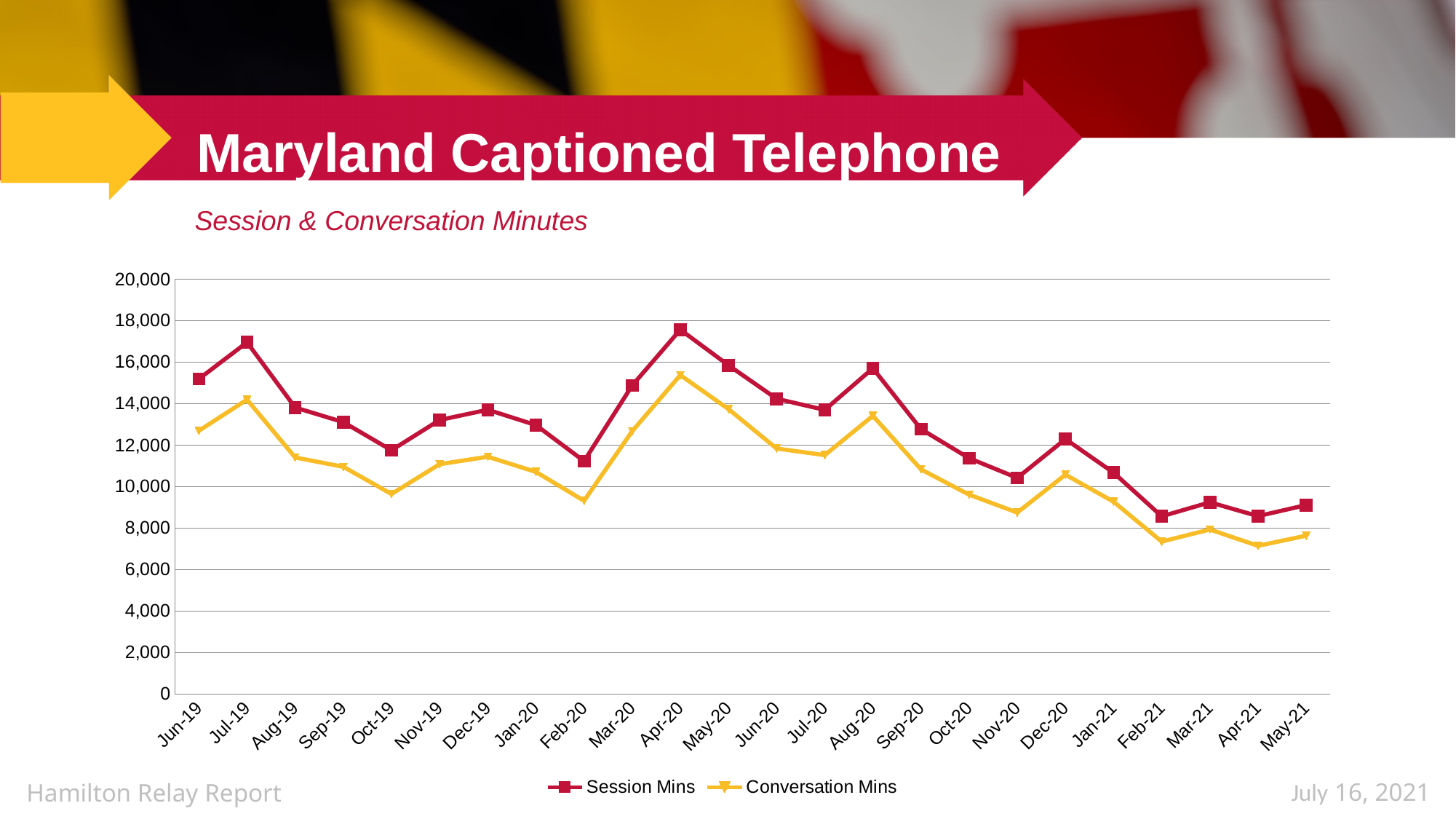
Overall, do the Session Mins values rise or fall from Jun-19 to May-21? fall How many series does the legend list? 2 In which month does Session Mins reach its highest value? Apr-20 What kind of chart is shown on the slide? line chart How many months are plotted along the x axis? 24 Is the value for Conversation Mins in May-21 greater or less than 8,000? less Is the value for Session Mins in Apr-20 greater or less than 16,000? greater Is the value for Session Mins in Oct-19 greater or less than 10,000? greater In which month does Conversation Mins reach its highest value? Apr-20 Which is larger for Session Mins: Jul-19 or Aug-19? Jul-19 What is the subtitle shown above the chart? Session & Conversation Minutes